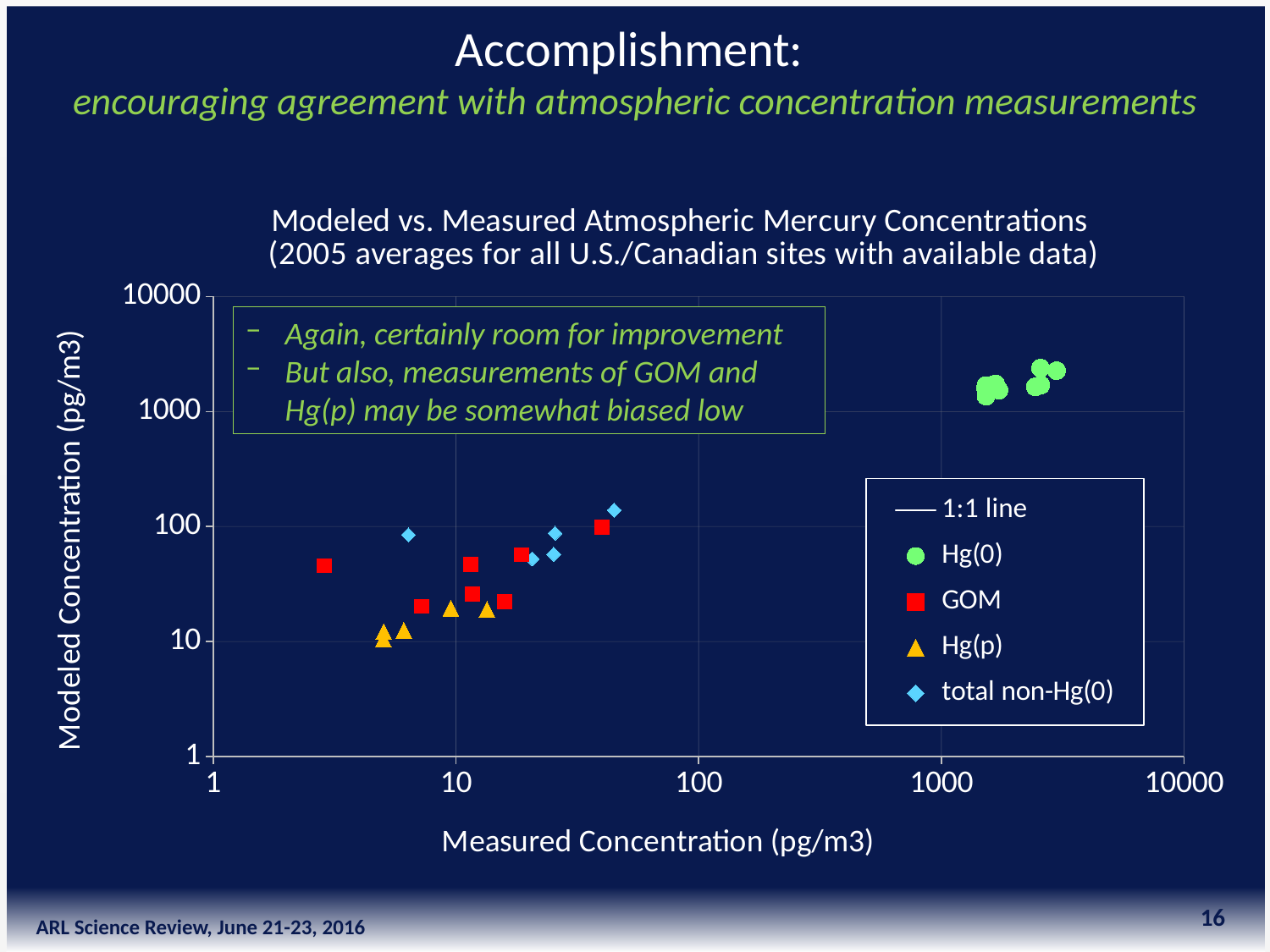
Which series has higher modeled concentrations, Hg(0) or GOM? Hg(0) Are the modeled concentrations of the Hg(p) points greater or less than 100 pg/m3? less Are the modeled concentrations of the Hg(0) points greater or less than 1000 pg/m3? greater Is the modeled concentration of the GOM point with the lowest measured concentration greater or less than 10 pg/m3? greater What is the title of the chart? Modeled vs. Measured Atmospheric Mercury Concentrations (2005 averages for all U.S./Canadian sites with available data) Which series has the highest modeled and measured concentrations? Hg(0) What kind of chart is shown on the slide? Scatter chart What is the label of the x axis? Measured Concentration (pg/m3) Which series has the lowest modeled concentrations? Hg(p) How many entries does the chart legend list? 5